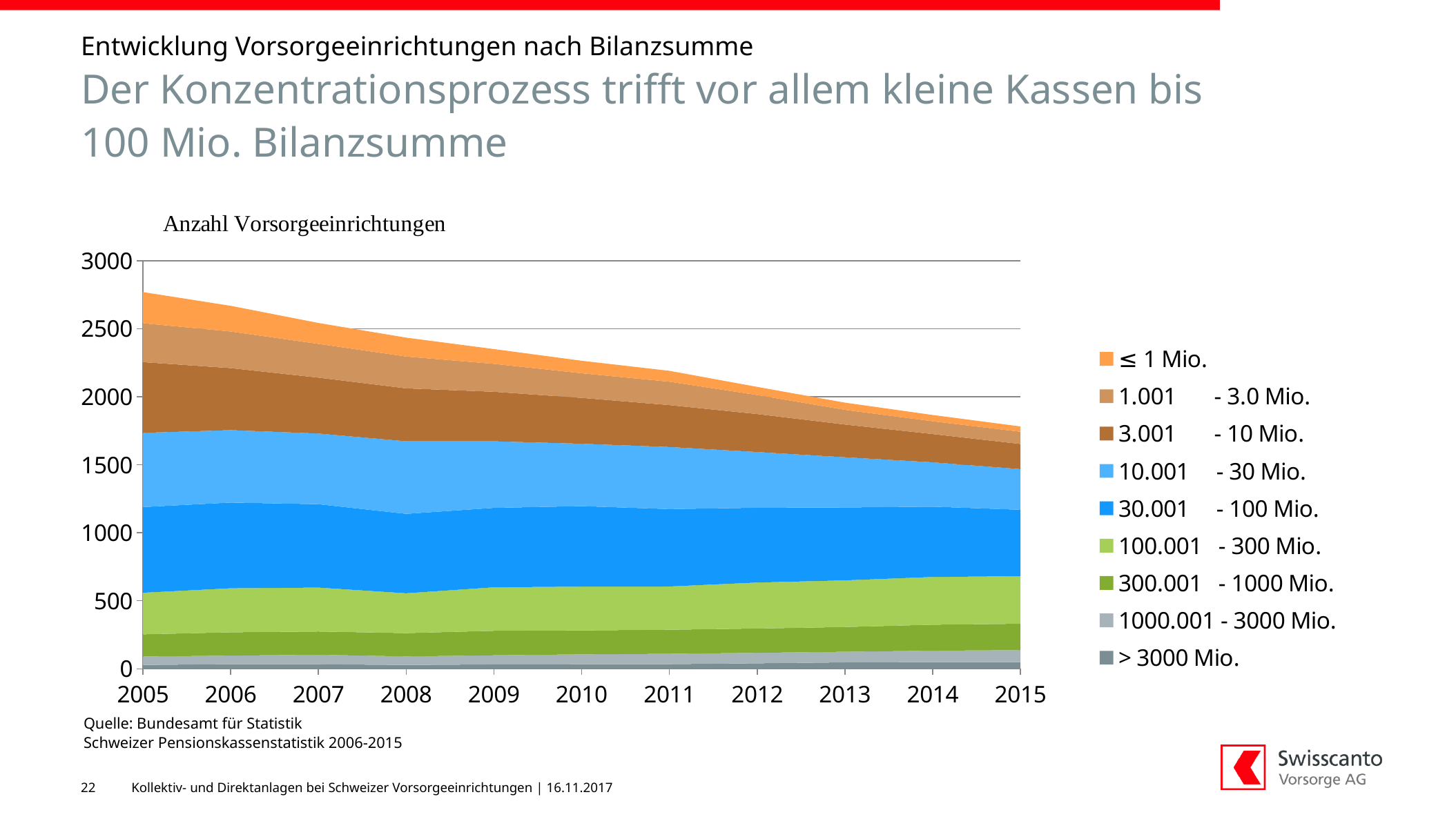
What is the first year shown on the x axis? 2005 Does the total number of Vorsorgeeinrichtungen rise or fall from 2005 to 2015? Fall What is the last year shown on the x axis? 2015 How many years are shown along the x axis? 11 Is the total number of Vorsorgeeinrichtungen in 2015 greater or less than 2000? less Which legend entry is listed last? > 3000 Mio. Is the total number of Vorsorgeeinrichtungen in 2005 greater or less than 2500? greater Is the total number of Vorsorgeeinrichtungen in 2010 greater or less than 2000? greater What is the title of the chart? Anzahl Vorsorgeeinrichtungen What kind of chart is shown on the slide? Stacked area chart How many series does the legend list? 9 Which year has the larger total number of Vorsorgeeinrichtungen, 2005 or 2015? 2005